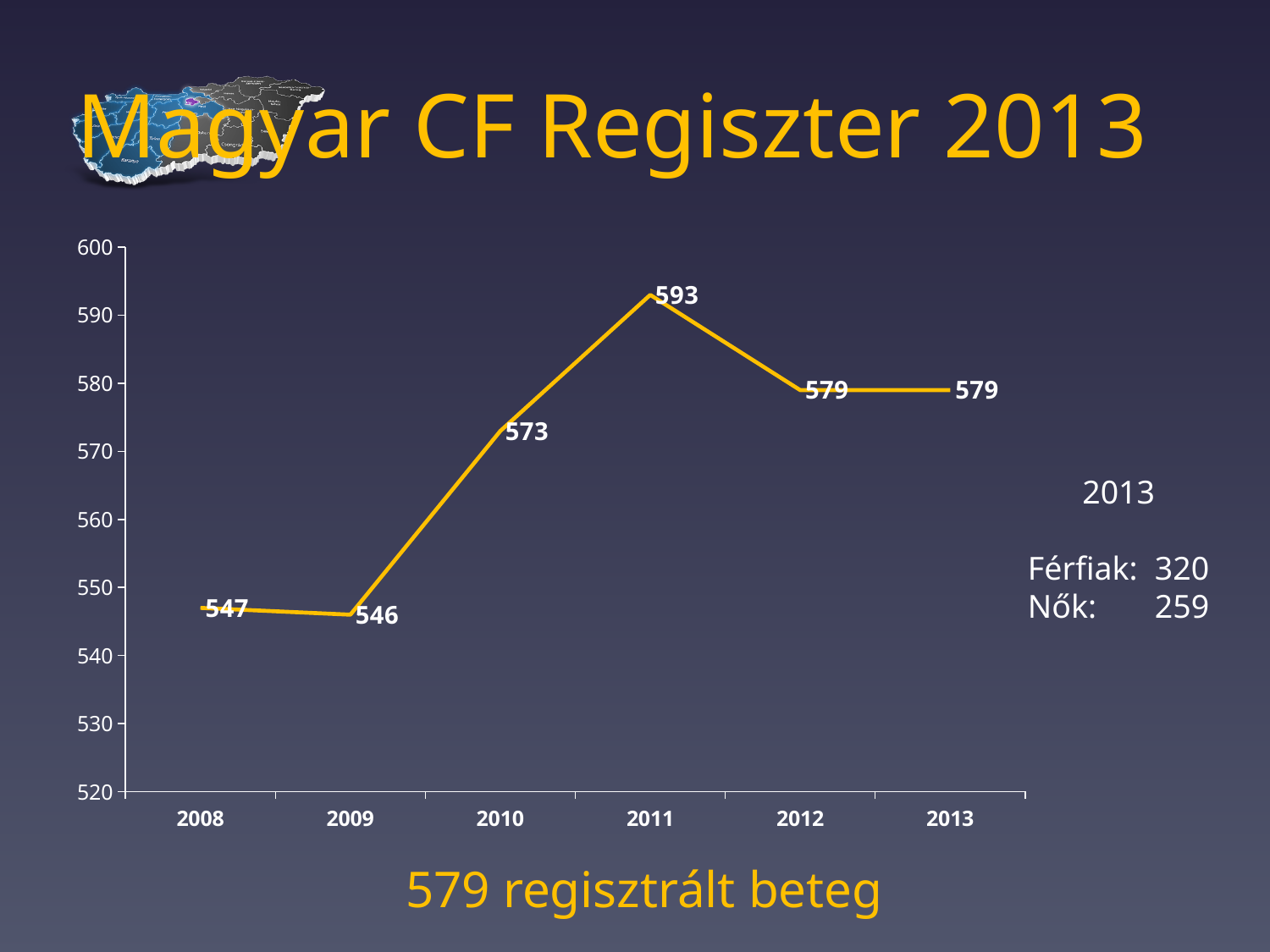
What is the difference between the values for 2011 and 2010? 20 What is the value for 2010? 573 What is the value for 2009? 546 Which year has the highest value? 2011 What is the difference between the values for 2013 and 2008? 32 What kind of chart is shown on the slide? line chart What is the value for 2011? 593 How many years are plotted on the chart? 6 Does the value rise or fall from 2009 to 2011? rise Is the value for 2011 greater or less than 590? greater Which year has the lowest value? 2009 Which is larger, the value for 2008 or the value for 2012? 2012